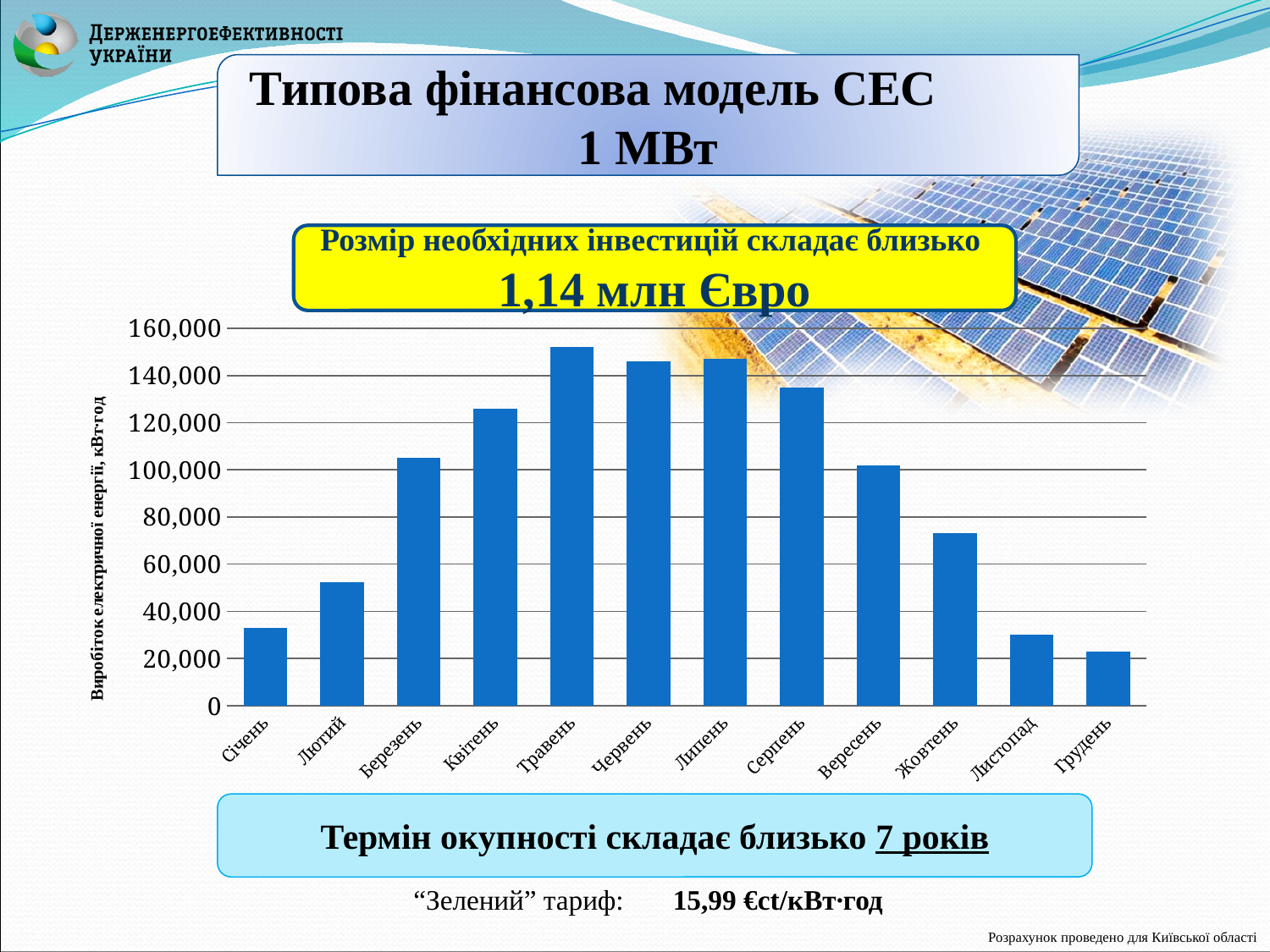
How do the values change from Січень to Травень along the x axis? they rise How many months (categories) are plotted on the chart? 12 Which month has the highest electricity generation on the chart? Травень Is the value for Січень greater or less than 40,000? less Which month has a larger value, Квітень or Серпень? Серпень What kind of chart is shown on the slide? bar chart Is the value for Жовтень greater or less than 80,000? less Is the value for Серпень greater or less than 140,000? less Which month has the lowest electricity generation on the chart? Грудень What is the label of the vertical axis of the chart? Виробіток електричної енергії, кВт·год